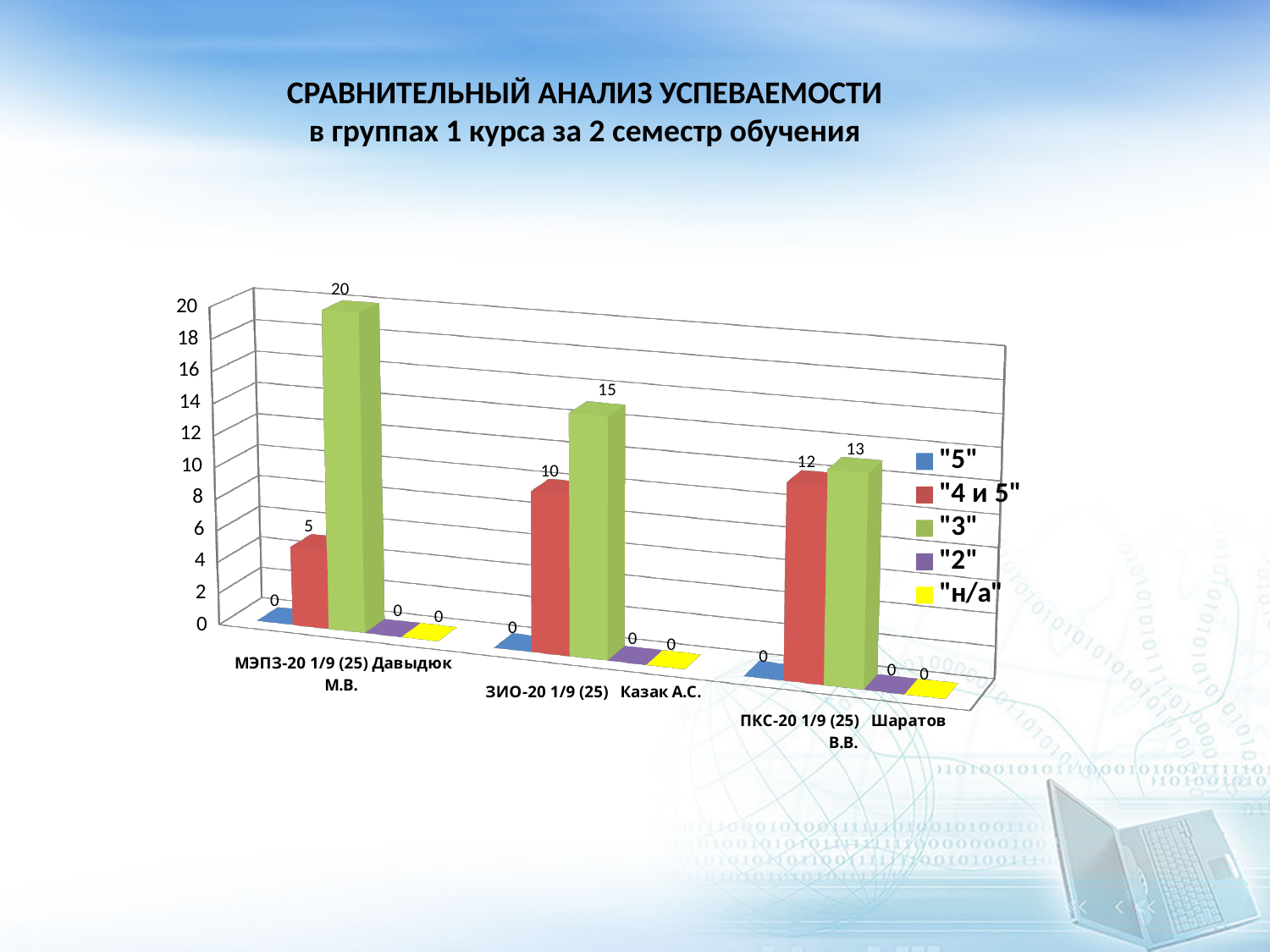
What type of chart is shown on the slide? bar chart For ЗИО-20 1/9 (25) Казак А.С., which is larger: "4 и 5" or "3"? "3" What is the difference between the "3" values for МЭПЗ-20 1/9 (25) Давыдюк М.В. and ЗИО-20 1/9 (25) Казак А.С.? 5 Which group has the highest value for "3"? МЭПЗ-20 1/9 (25) Давыдюк М.В. What is the value of "3" for ПКС-20 1/9 (25) Шаратов В.В.? 13 What is the value of "4 и 5" for ЗИО-20 1/9 (25) Казак А.С.? 10 Which group has the lowest value for "4 и 5"? МЭПЗ-20 1/9 (25) Давыдюк М.В. How many series does the legend list? 5 What is the value of "3" for МЭПЗ-20 1/9 (25) Давыдюк М.В.? 20 What is the value of "4 и 5" for ПКС-20 1/9 (25) Шаратов В.В.? 12 What is the value of "5" for ЗИО-20 1/9 (25) Казак А.С.? 0 How many groups (categories) are shown on the x axis? 3